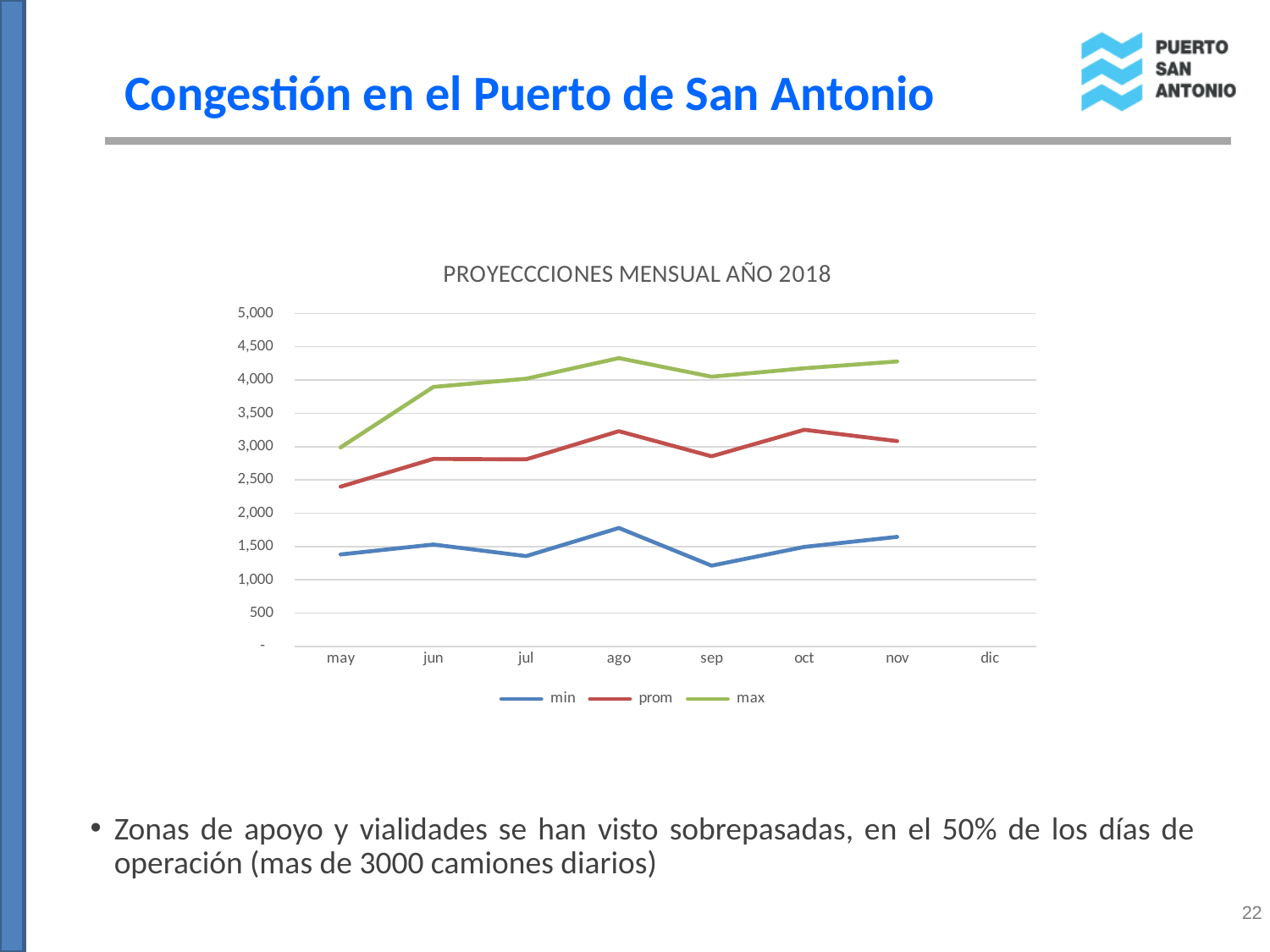
In which month is the min series at its lowest value? sep How many series does the legend list? 3 Is the value of the max series in jun greater or less than 3,500? greater What kind of chart is shown on the slide? line chart In which month is the prom series at its lowest value? may In which month is the min series at its highest value? ago What is the title of the chart? PROYECCCIONES MENSUAL AÑO 2018 Is the value of the prom series in may greater or less than 2,500? less What are the series names listed in the legend? min, prom, max Which is larger, the prom value in oct or the prom value in sep? oct In which month is the max series at its lowest value? may How many months are labelled on the x axis? 8